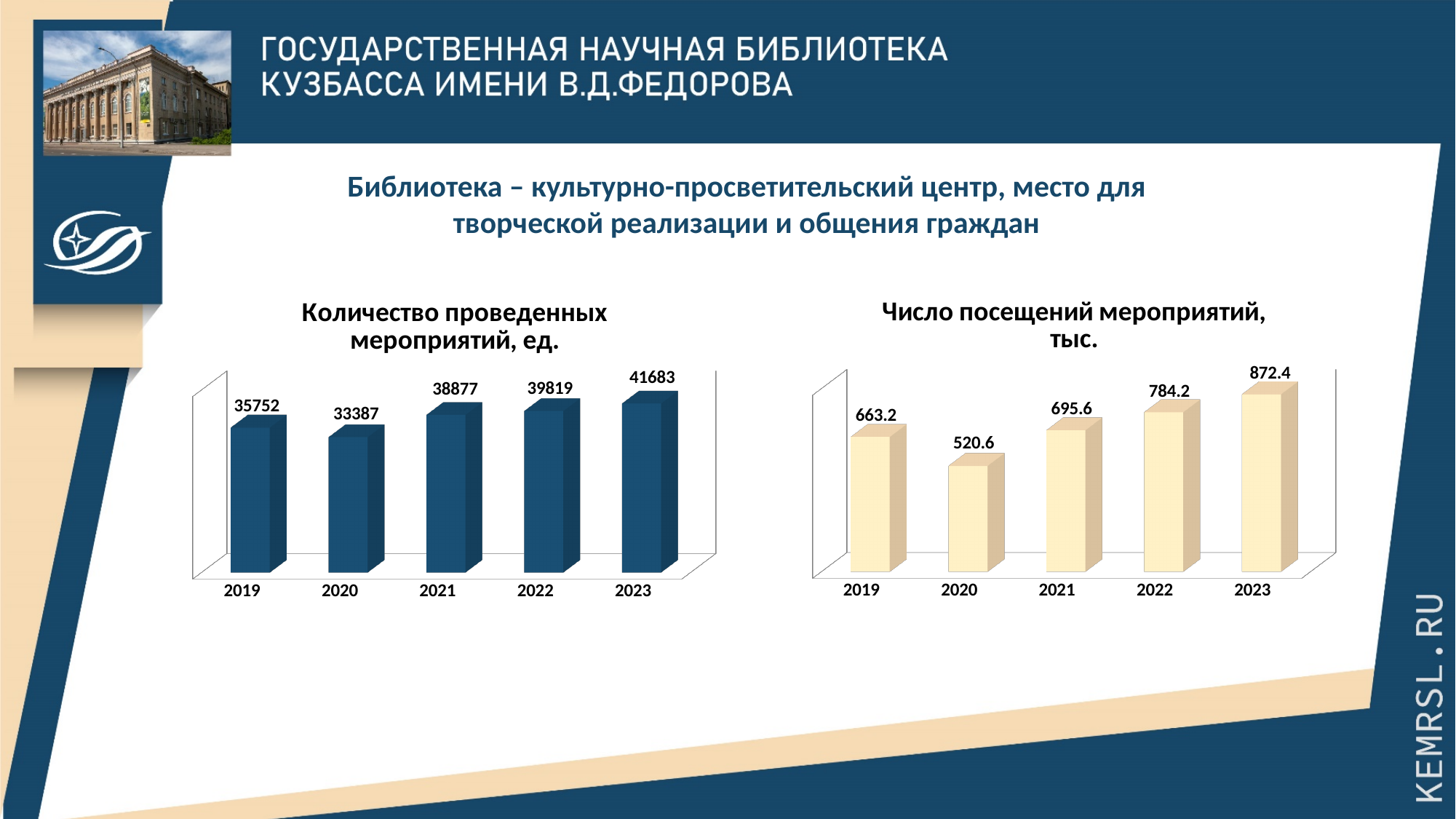
In the chart titled "Число посещений мероприятий, тыс.", which year has the lowest value? 2020 How many years are shown in the chart titled "Число посещений мероприятий, тыс."? 5 In the chart titled "Количество проведенных мероприятий, ед.", what is the value for 2021? 38877 In the chart titled "Число посещений мероприятий, тыс.", what is the difference between the values for 2023 and 2020? 351.8 What kind of chart is the chart titled "Количество проведенных мероприятий, ед."? bar chart In the chart titled "Количество проведенных мероприятий, ед.", which year has the highest value? 2023 What is the title of the left chart on the slide? Количество проведенных мероприятий, ед. In the chart titled "Число посещений мероприятий, тыс.", what is the value for 2022? 784.2 In the chart titled "Количество проведенных мероприятий, ед.", what is the difference between the values for 2023 and 2019? 5931 In the chart titled "Число посещений мероприятий, тыс.", do the values rise or fall from 2020 to 2023? rise In the chart titled "Количество проведенных мероприятий, ед.", which is larger, the value for 2020 or the value for 2022? 2022 In the chart titled "Число посещений мероприятий, тыс.", which is larger, the value for 2019 or the value for 2021? 2021